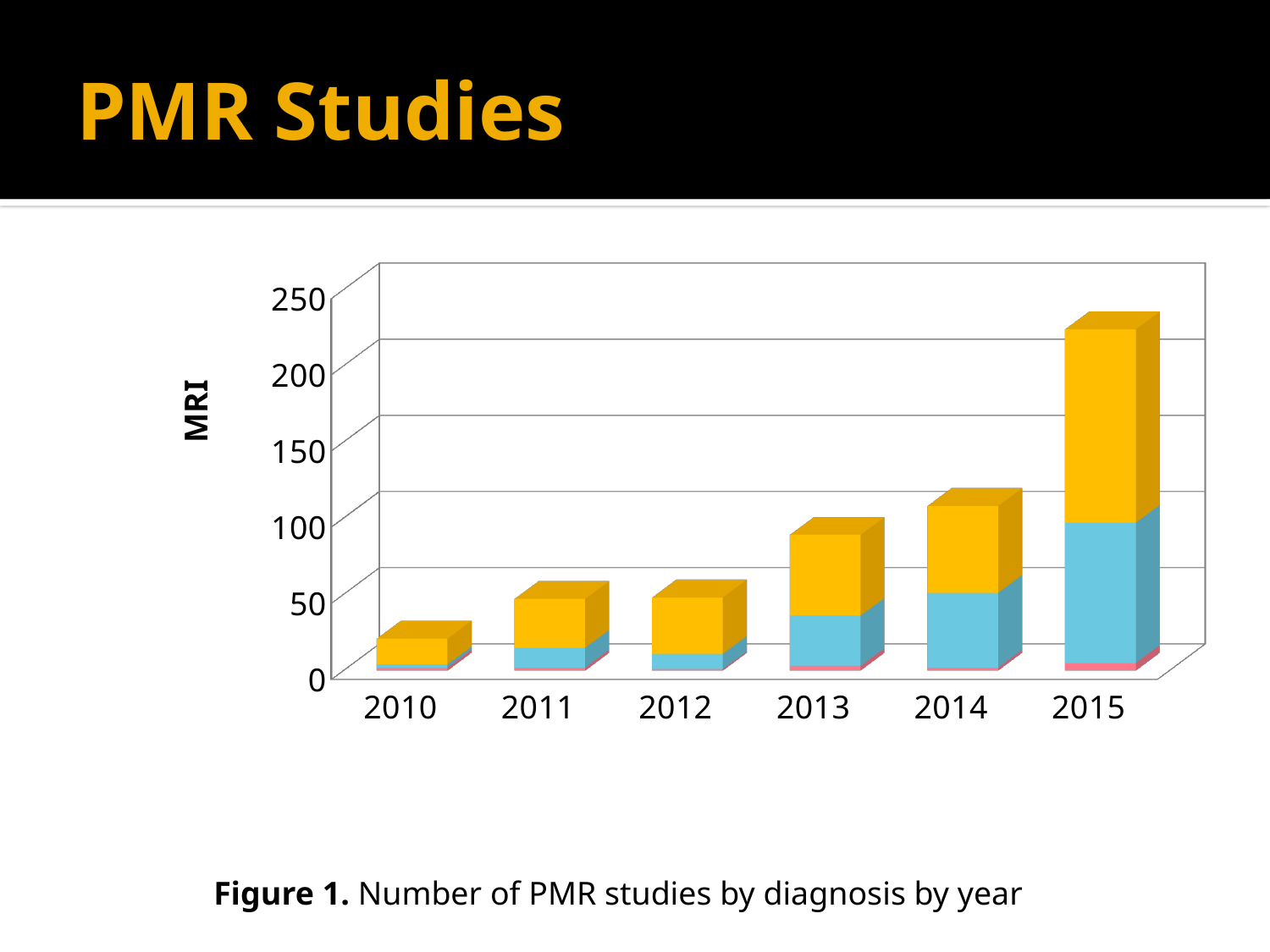
Which bar is taller, 2010 or 2013? 2013 What is the label on the vertical axis of the chart? MRI Is the total bar height for 2013 greater or less than 50? greater Is the total bar height for 2010 greater or less than 50? less Which bar is taller, 2014 or 2015? 2015 Is the total bar height for 2015 greater or less than 200? greater Which year has the shortest bar in the chart? 2010 What kind of chart is shown on the slide? bar chart How many years are shown on the x axis of the chart? 6 Do the bar heights generally rise or fall from 2010 to 2015? rise Which year has the tallest bar in the chart? 2015